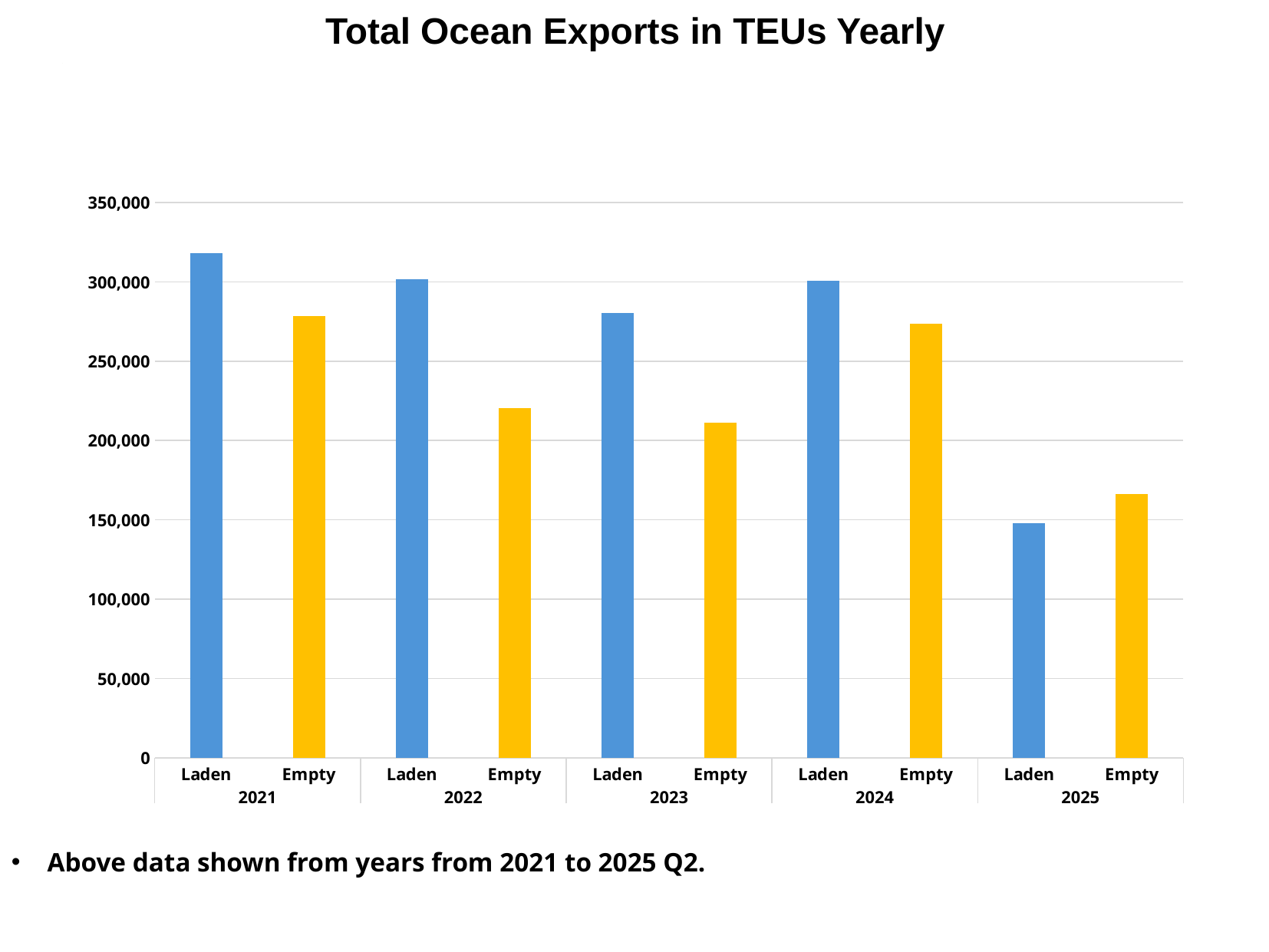
Is the value for Laden in 2021 greater or less than 300,000? greater Is the value for Laden in 2023 greater or less than 300,000? less In 2025, which is larger, Laden or Empty? Empty Which is larger, Empty in 2022 or Empty in 2024? Empty in 2024 Which bar is the lowest in the chart? Laden 2025 How many bars are plotted in the chart? 10 Which bar is the highest in the chart? Laden 2021 Is the value for Empty in 2025 greater or less than 200,000? less What is the title of the chart? Total Ocean Exports in TEUs Yearly How many years are shown on the x axis of the chart? 5 What kind of chart is shown on the slide? Bar chart